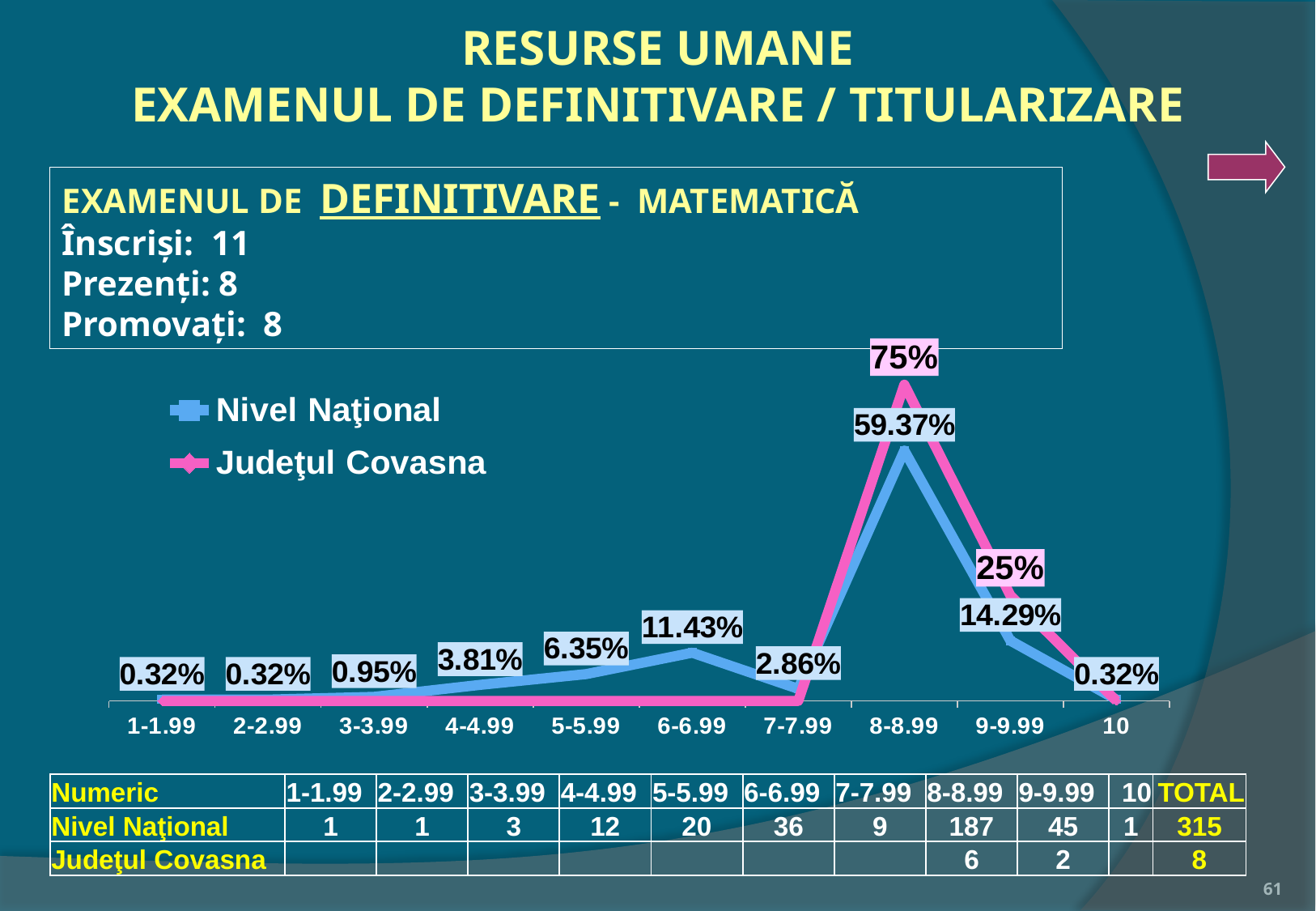
What is the value for Nivel Naţional in the 8-8.99 interval? 59.37% How many score intervals are shown on the x axis of the chart? 10 How many series does the chart legend list? 2 In which interval does Nivel Naţional reach its highest value? 8-8.99 What is the value for Judeţul Covasna in the 9-9.99 interval? 25% Which series has the larger value in the 9-9.99 interval, Nivel Naţional or Judeţul Covasna? Judeţul Covasna What is the difference between the Nivel Naţional values for 6-6.99 and 7-7.99? 8.57% What is the value for Nivel Naţional in the 6-6.99 interval? 11.43% Which colour is used for the Judeţul Covasna line in the chart? pink What kind of chart is shown on the slide? line chart What is the value for Judeţul Covasna in the 8-8.99 interval? 75% What is the difference between Judeţul Covasna and Nivel Naţional in the 8-8.99 interval? 15.63%